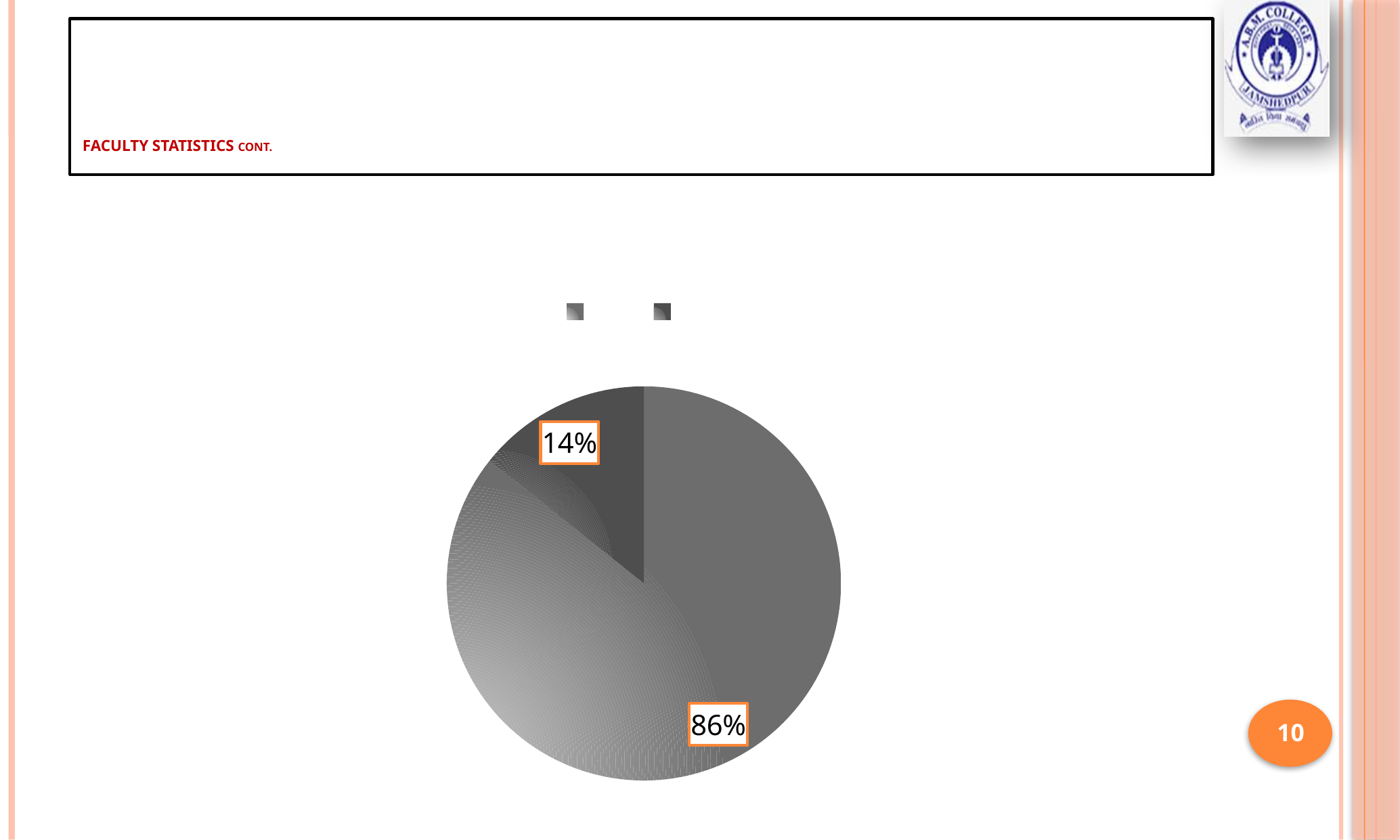
How many entries does the legend above the pie chart show? 2 What is the value of the smallest slice of the pie chart? 14% How many slices does the pie chart have? 2 Is the larger slice of the pie chart more or less than half of the pie? more What colour is the border around the data labels on the pie chart? orange What is the value of the largest slice of the pie chart? 86% What share of the pie does the smaller slice represent? 14% What kind of chart is shown on the slide? pie chart What is the difference between the two slice values in the pie chart? 72 percentage points What do the two slice values of the pie chart add up to? 100% What is the heading text shown in the box at the top of the slide? FACULTY STATISTICS CONT.